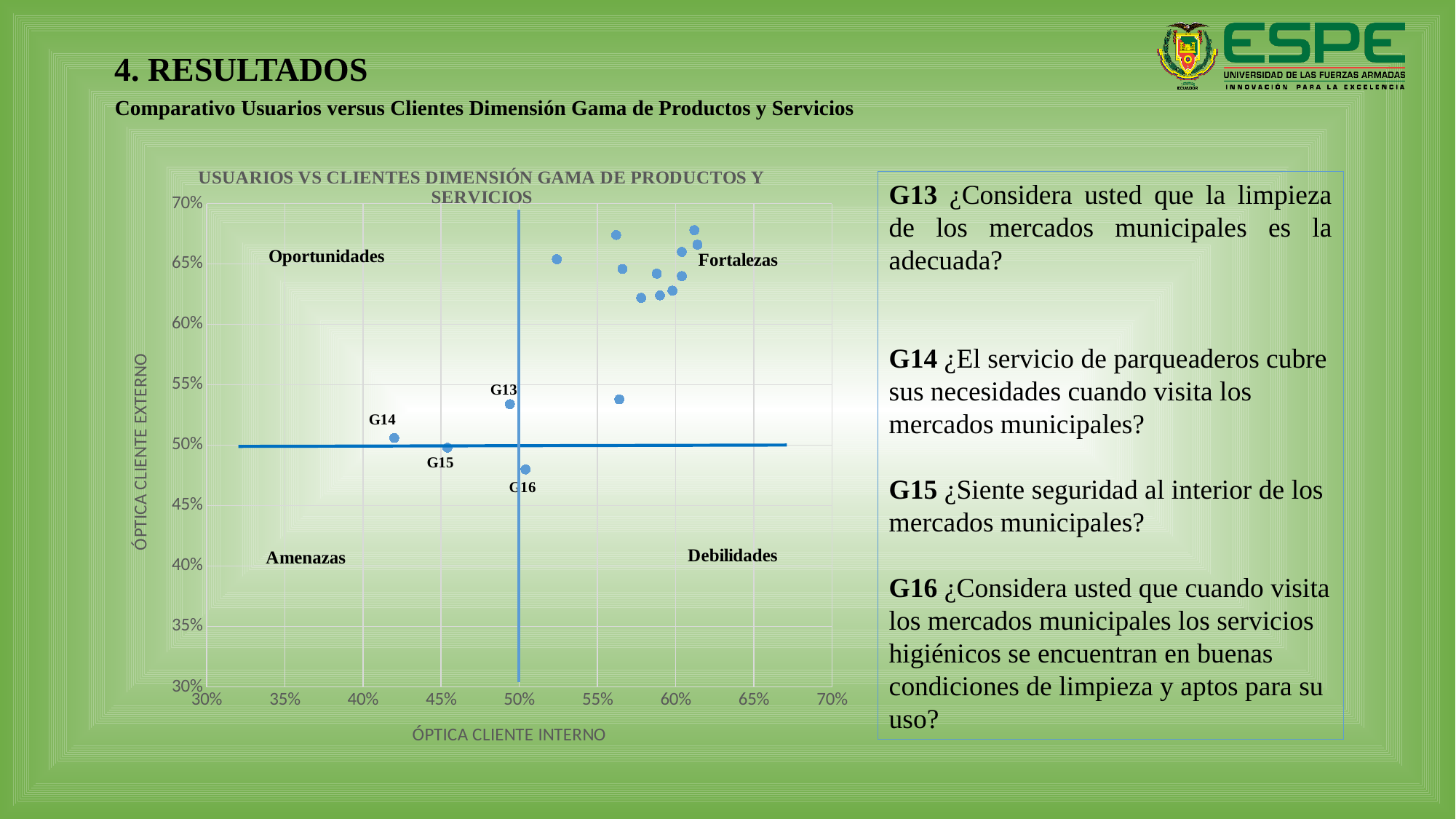
What kind of chart is shown on the slide? scatter chart What is the title of the chart? USUARIOS VS CLIENTES DIMENSIÓN GAMA DE PRODUCTOS Y SERVICIOS Which labelled point has a higher ÓPTICA CLIENTE INTERNO value, G14 or G16? G16 Is the ÓPTICA CLIENTE EXTERNO value for G16 greater or less than 50%? less Which of the four labelled points (G13, G14, G15, G16) has the highest ÓPTICA CLIENTE EXTERNO value? G13 What is the label of the vertical axis of the chart? ÓPTICA CLIENTE EXTERNO How many points in the chart are labelled with a G code? 4 Which of the four labelled points (G13, G14, G15, G16) has the lowest ÓPTICA CLIENTE EXTERNO value? G16 Is the ÓPTICA CLIENTE EXTERNO value for G14 greater or less than 55%? less Is the ÓPTICA CLIENTE EXTERNO value for G13 greater or less than 50%? greater Which labelled point has a higher ÓPTICA CLIENTE EXTERNO value, G13 or G16? G13